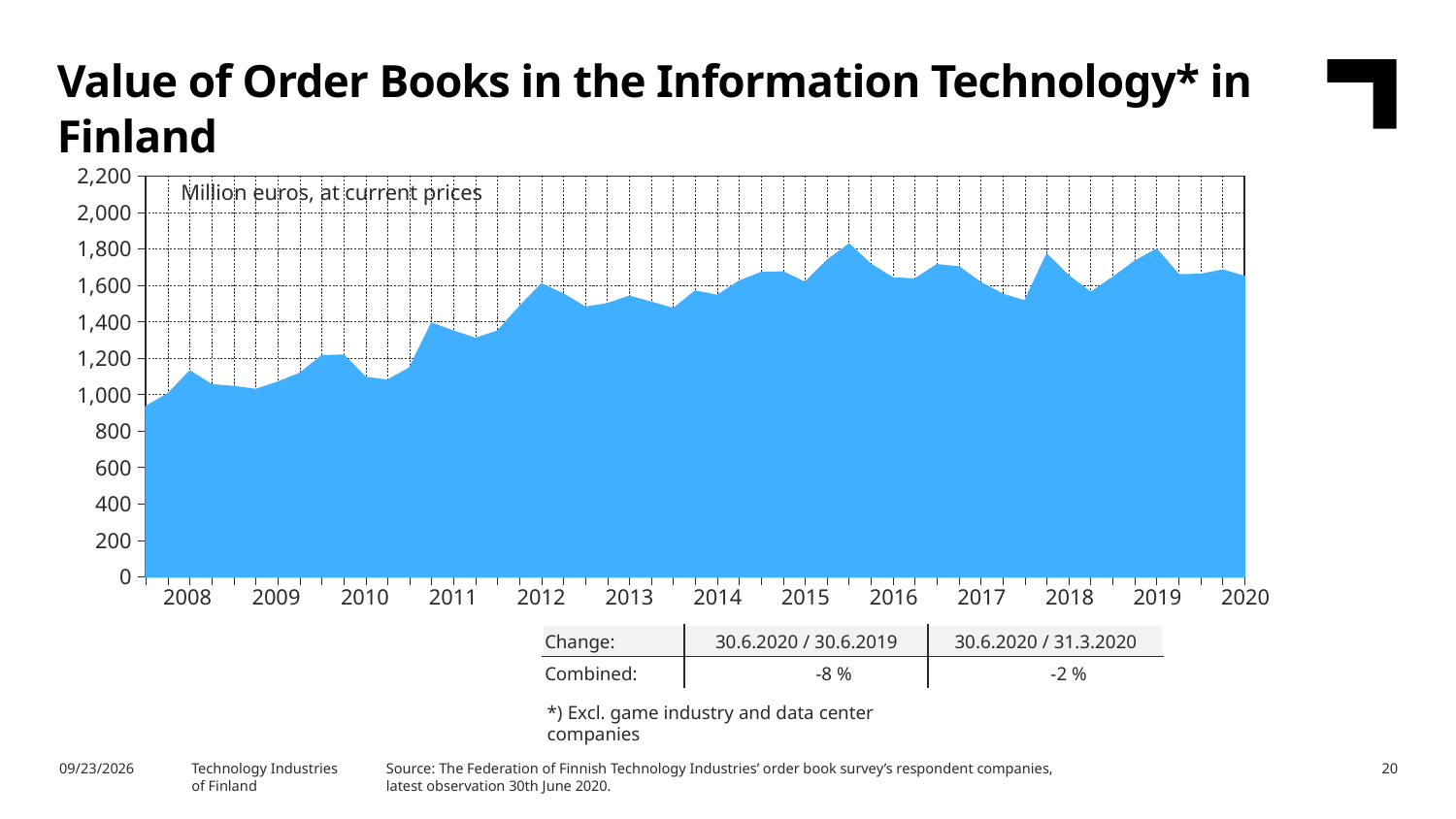
Is the value at the start of 2019 greater or less than 1,600? greater Overall, do the values rise or fall from 2008 to 2020? rise In which year does the chart show its lowest value? 2008 Is the value at the start of 2009 greater or less than 1,200? less How many years are labelled on the x axis? 13 What is the title of the chart on the slide? Value of Order Books in the Information Technology* in Finland What kind of chart is shown on the slide? area chart What unit is stated for the values in the chart? Million euros, at current prices Is the value at the start of 2010 greater or less than 1,000? greater